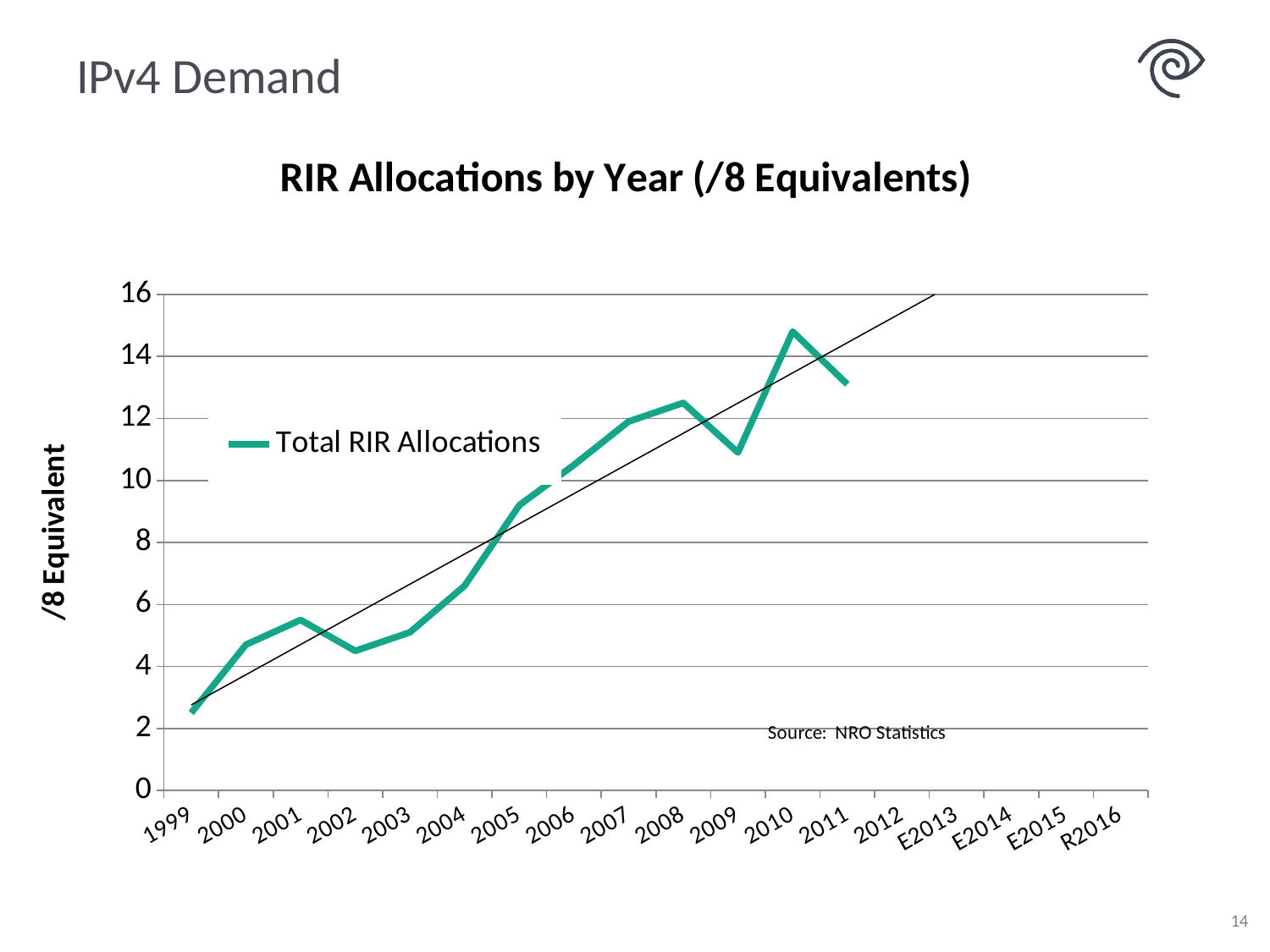
What kind of chart is shown on the slide? line chart Is the value for Total RIR Allocations in 2009 greater or less than 10? greater In which year does the Total RIR Allocations line reach its highest value? 2010 Which year has the larger Total RIR Allocations value, 2008 or 2009? 2008 What is the label on the vertical axis of the chart? /8 Equivalent In which year does the Total RIR Allocations line have its lowest value? 1999 What is the title of the chart? RIR Allocations by Year (/8 Equivalents) How many year categories are shown along the x axis? 18 How many series does the chart legend list? 1 Is the value for Total RIR Allocations in 2002 greater or less than 6? less Overall, do Total RIR Allocations rise or fall from 1999 to 2011? rise Is the value for Total RIR Allocations in 2010 greater or less than 14? greater